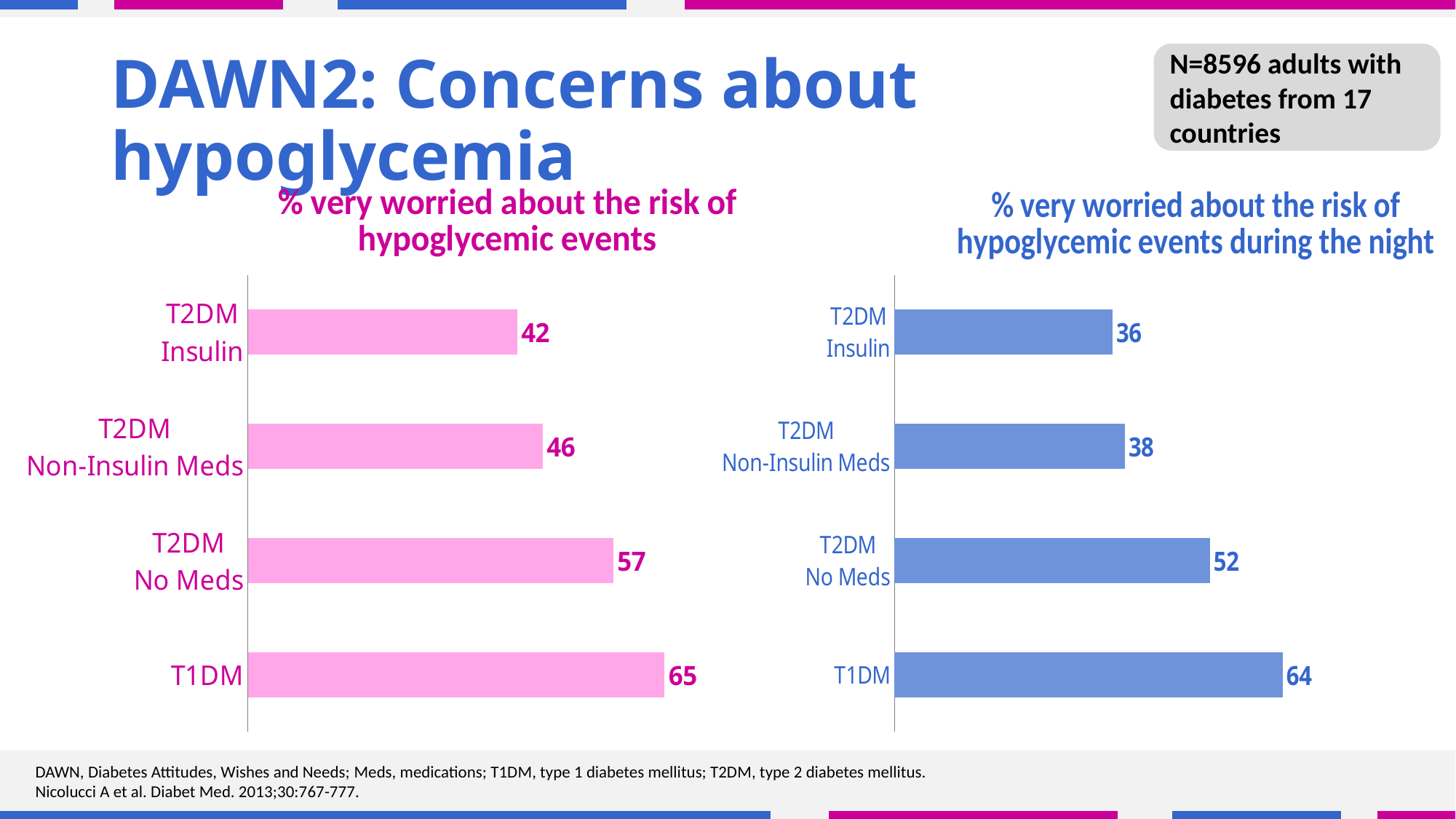
What kind of chart is the left chart (% very worried about the risk of hypoglycemic events)? Bar chart What colour are the bars in the right chart (% very worried about the risk of hypoglycemic events during the night)? Blue In the right chart (% very worried about the risk of hypoglycemic events during the night), what is the value for T2DM Non-Insulin Meds? 38 In the right chart (% very worried about the risk of hypoglycemic events during the night), what is the value for T2DM No Meds? 52 How many categories are shown in the right chart (% very worried about the risk of hypoglycemic events during the night)? 4 In the right chart (% very worried about the risk of hypoglycemic events during the night), what is the difference between the values for T2DM No Meds and T2DM Non-Insulin Meds? 14 In the left chart (% very worried about the risk of hypoglycemic events), what is the difference between the values for T1DM and T2DM Insulin? 23 In the left chart (% very worried about the risk of hypoglycemic events), what is the value for T2DM Insulin? 42 Which chart shows a higher value for T1DM: the left chart or the right chart? The left chart In the right chart (% very worried about the risk of hypoglycemic events during the night), which category has the lowest value? T2DM Insulin In the left chart (% very worried about the risk of hypoglycemic events), which category has the highest value? T1DM In the left chart (% very worried about the risk of hypoglycemic events), which is larger: the value for T2DM No Meds or T2DM Non-Insulin Meds? T2DM No Meds